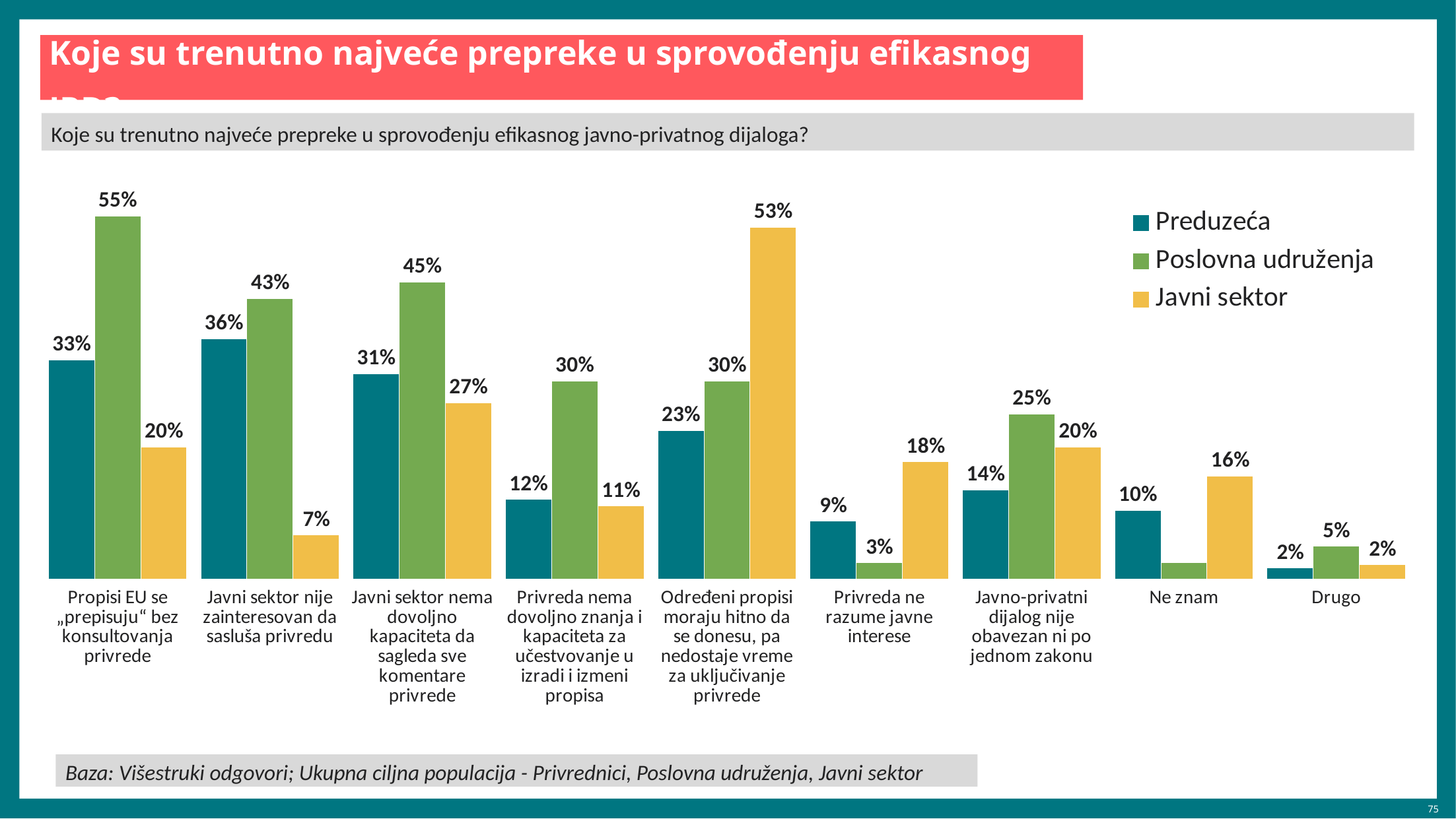
How many series does the legend list? 3 Which category has the highest Preduzeća value? Javni sektor nije zainteresovan da sasluša privredu For "Privreda ne razume javne interese", which is larger: the Preduzeća value or the Javni sektor value? Javni sektor What is the Poslovna udruženja value for "Propisi EU se „prepisuju“ bez konsultovanja privrede"? 55% What is the Javni sektor value for "Određeni propisi moraju hitno da se donesu, pa nedostaje vreme za uključivanje privrede"? 53% Which category has the lowest Poslovna udruženja value among those with a printed label? Privreda ne razume javne interese What is the Preduzeća value for "Javni sektor nije zainteresovan da sasluša privredu"? 36% Which series is shown in yellow in the legend? Javni sektor How many categories are shown on the x axis? 9 What kind of chart is shown on the slide? Bar chart What is the Javni sektor value for "Ne znam"? 16% What is the difference between the Poslovna udruženja and Javni sektor values for "Javni sektor nije zainteresovan da sasluša privredu"? 36 percentage points